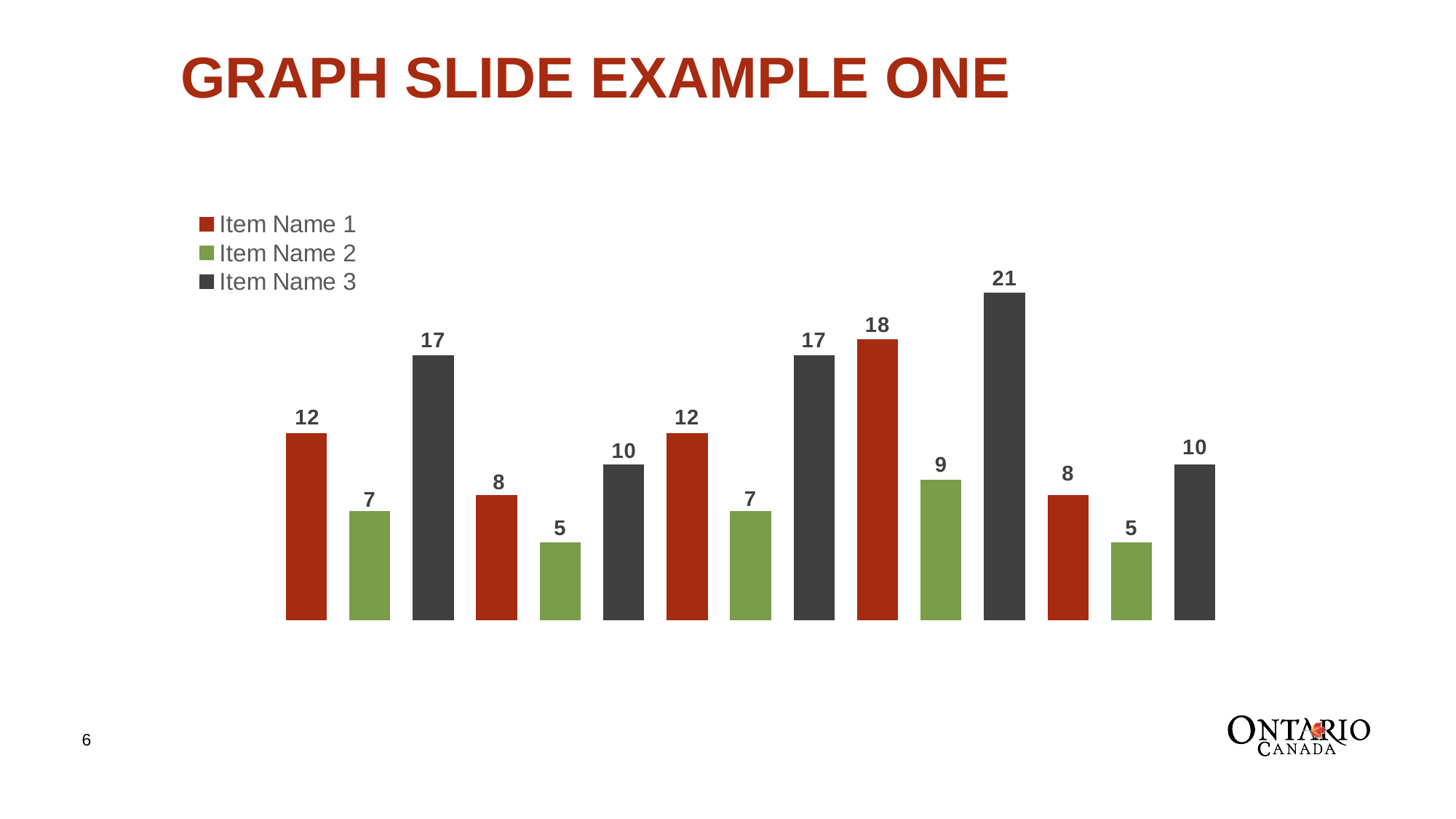
What is the value of Item Name 3 in the first group of bars? 17 What is the title of the slide containing the chart? GRAPH SLIDE EXAMPLE ONE Which series is shown in green in the legend? Item Name 2 How many groups of bars are plotted along the x axis? 5 What is the highest value shown for Item Name 3? 21 What is the value of Item Name 1 in the fourth group of bars? 18 In the fourth group of bars, what is the difference between Item Name 3 and Item Name 1? 3 How many series does the legend list? 3 What is the lowest value shown for Item Name 2? 5 What is the value of Item Name 2 in the second group of bars? 5 What kind of chart is shown on the slide? bar chart In the first group of bars, which is larger, Item Name 1 or Item Name 2? Item Name 1